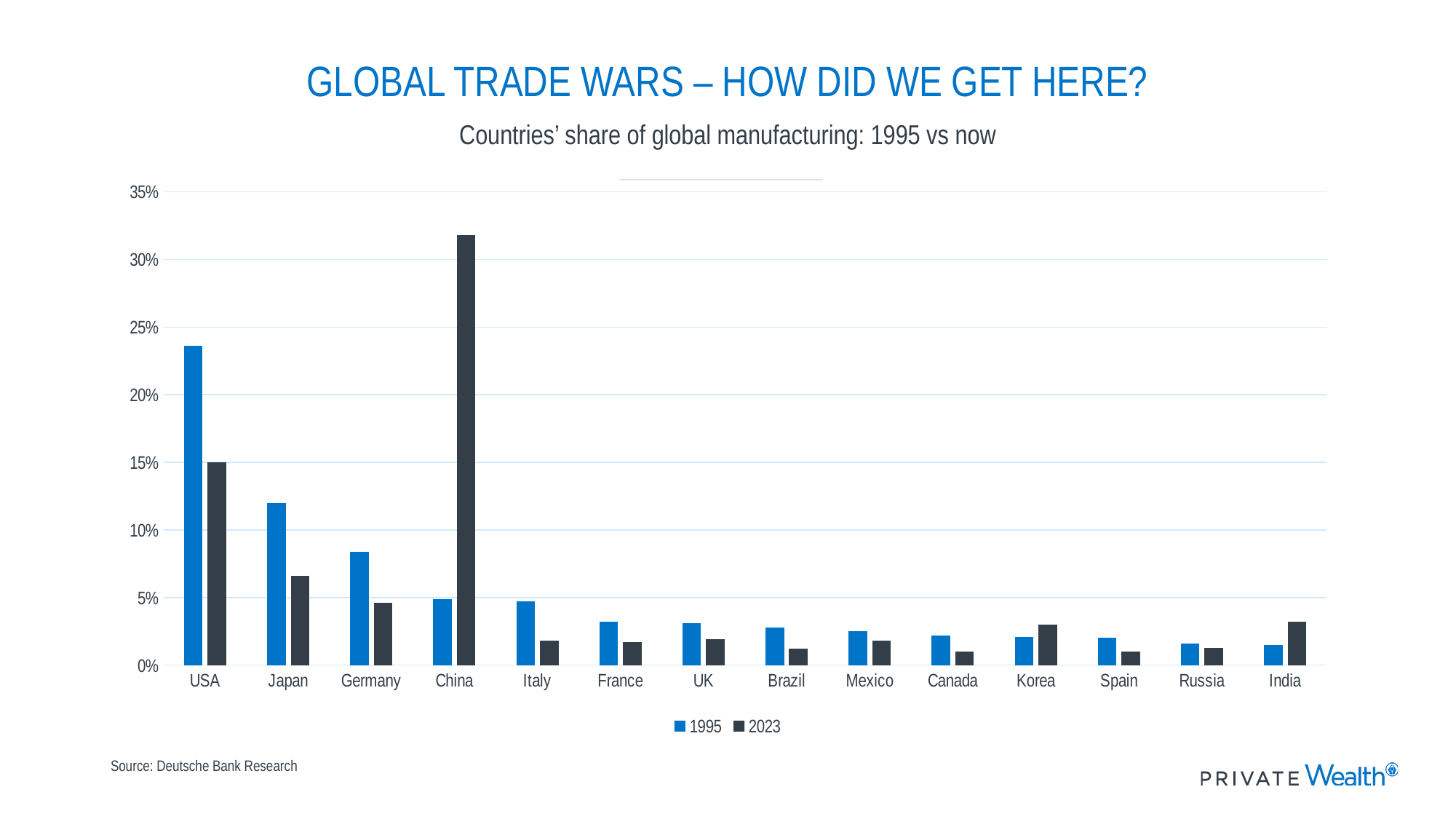
Which is larger: Japan's 1995 value or Germany's 1995 value? Japan's 1995 value Is China's 2023 value greater or less than 30%? greater Is the USA's 1995 value greater or less than 20%? greater Which country has the highest share of global manufacturing in the 2023 series? China Which country has the highest share of global manufacturing in the 1995 series? USA How many countries are shown on the x axis of the chart? 14 Do the 1995 values generally rise or fall moving from left to right along the x axis? fall What kind of chart is shown on the slide? bar chart Is Germany's 1995 value greater or less than 10%? less For Korea, which is larger: the 1995 value or the 2023 value? the 2023 value How many series does the legend list? 2